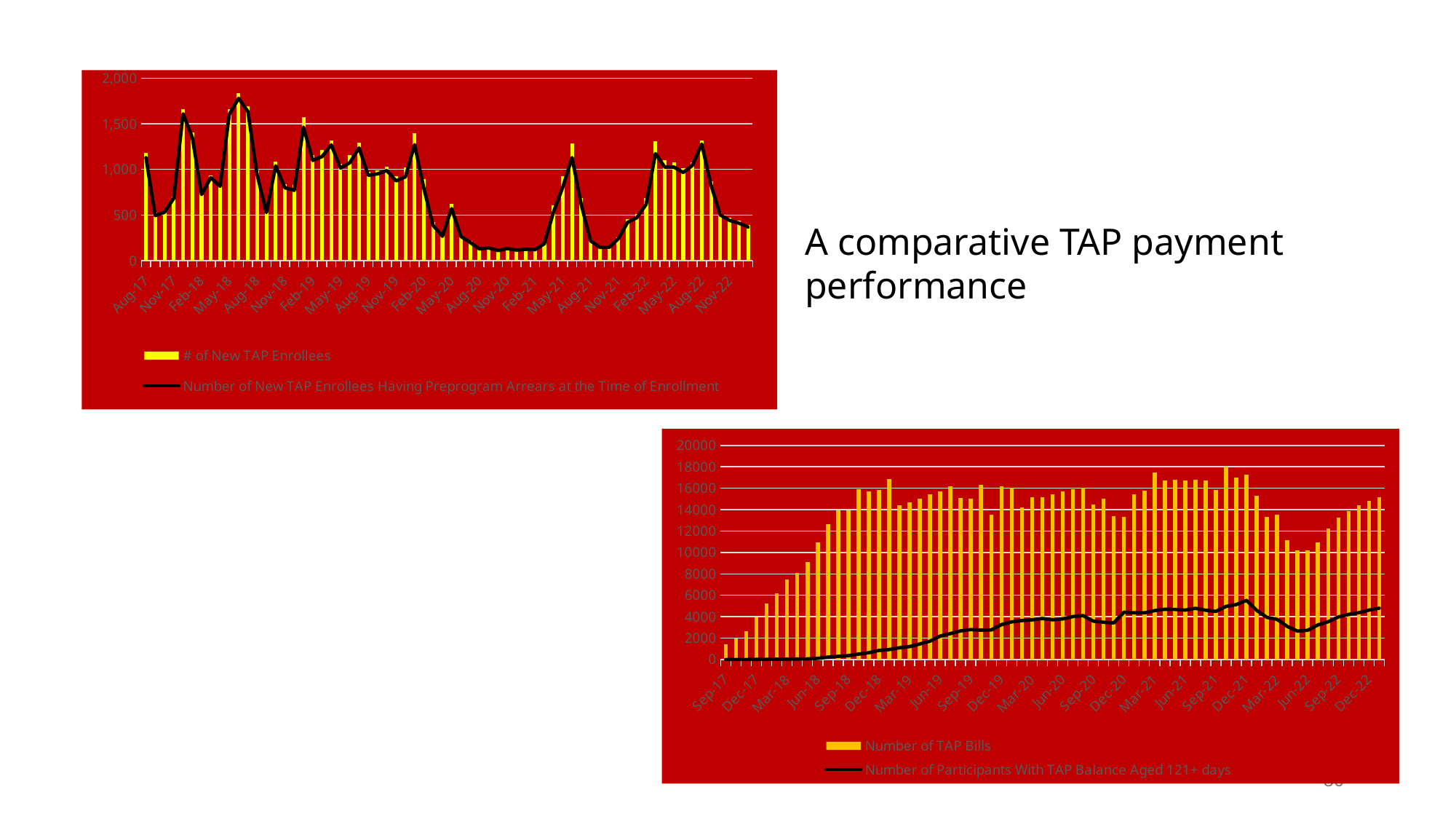
In the bottom-right chart, does the number of participants with TAP balance aged 121+ days generally rise or fall from Sep-17 to Dec-22? rise What kind of chart is the bottom-right chart? Bar chart with a line series In the top-left chart, which has more new TAP enrollees, Feb-18 or Nov-20? Feb-18 In the bottom-right chart, which has more TAP bills, Dec-18 or Jun-22? Dec-18 In the top-left chart, is the number of new TAP enrollees for May-18 greater or less than 1,500? greater In the bottom-right chart, is the number of TAP bills for Sep-17 greater or less than 2000? less How many series does the legend of the top-left chart list? 2 How many series does the legend of the bottom-right chart list? 2 In the top-left chart, is the number of new TAP enrollees for Nov-20 greater or less than 500? less What does the black line in the bottom-right chart represent, according to the legend? Number of Participants With TAP Balance Aged 121+ days